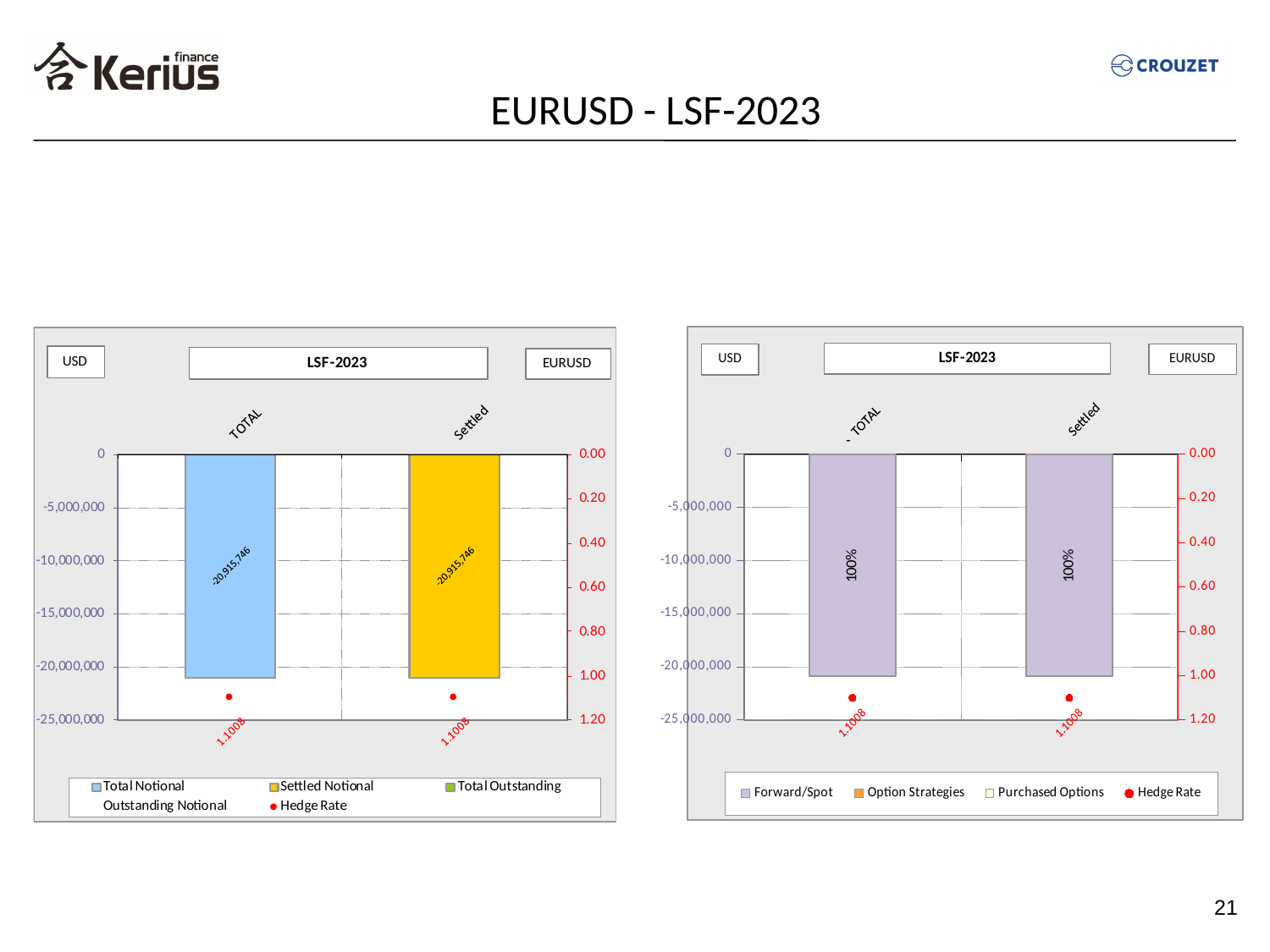
On the left chart, what is the Hedge Rate value shown for Settled? 1.1008 How many entries does the legend of the left chart list? 5 What type of chart is the left chart? Combination bar and line chart On the right chart, what is the Hedge Rate value shown for Settled? 1.1008 How many categories are shown on the x axis of the left chart? 2 On the right chart, what percentage is labelled on the Settled bar? 100% How many entries does the legend of the right chart list? 4 On the left chart, what is the Hedge Rate value shown for TOTAL? 1.1008 On the left chart, what is the difference between the TOTAL bar value and the Settled bar value? 0 On the left chart, what is the data label on the TOTAL bar? -20,915,746 On the left chart, what is the data label on the Settled bar? -20,915,746 On the right chart, what percentage is labelled on the TOTAL bar? 100%